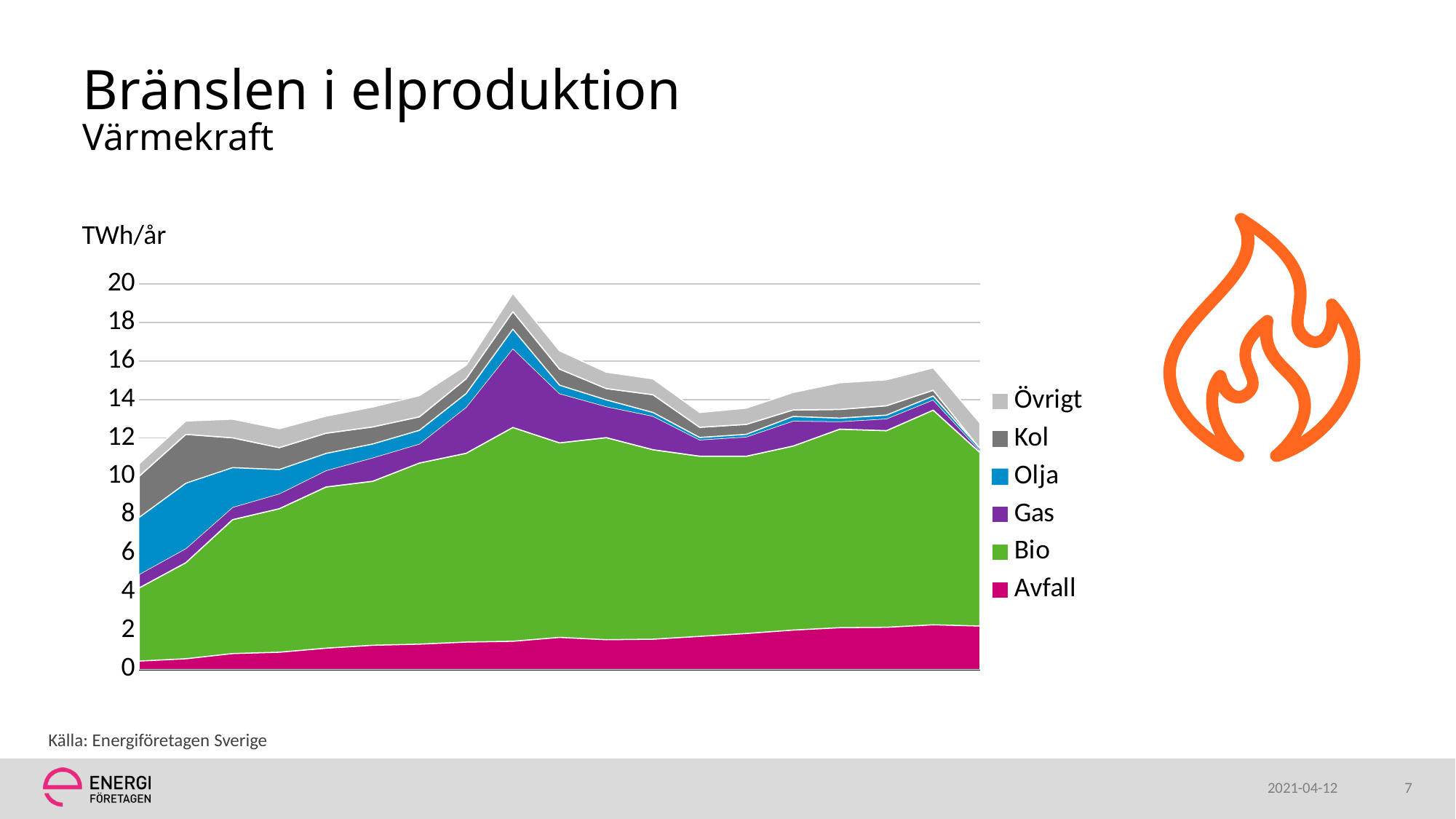
Is the total value at the left edge of the chart greater or less than 12? less Does the Bio series rise or fall from the left edge to the right edge of the chart? rise What kind of chart is shown on the slide? stacked area chart How many series does the legend list? 6 Does the Avfall series rise or fall from the left edge to the right edge of the chart? rise Is the highest total value reached by the stacked areas greater or less than 18? greater Does the Olja series rise or fall from the left edge to the right edge of the chart? fall Which series occupies the largest area of the chart? Bio What unit is shown on the y axis of the chart? TWh/år At the left edge of the chart, which is larger, the Olja band or the Gas band? Olja Which series is listed at the bottom of the legend? Avfall Is the highest total value reached by the stacked areas greater or less than 20? less